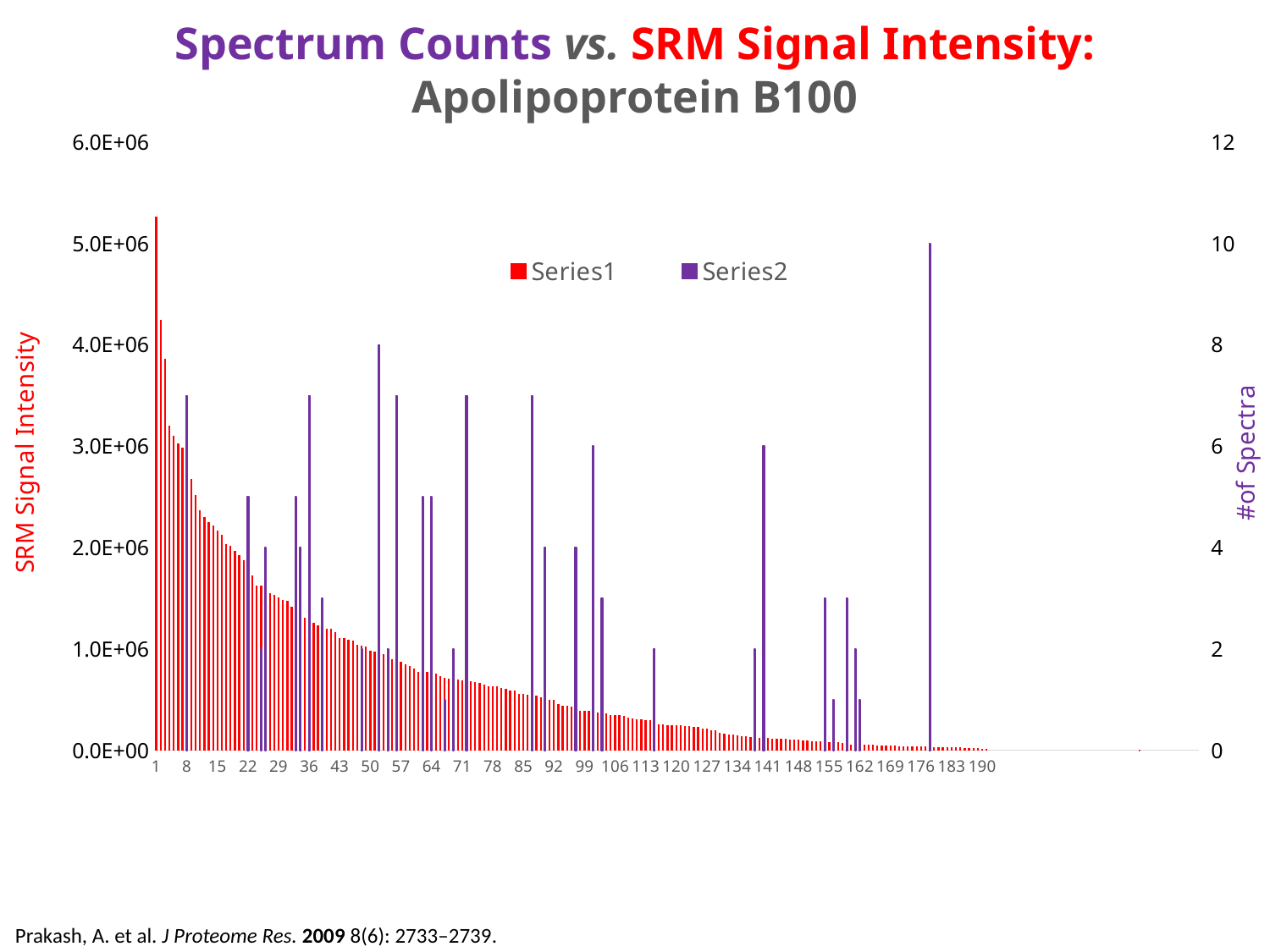
What is the highest value reached by any Series2 (purple) bar on the right axis? 10 Is the Series1 value for category 50 greater or less than 2.0E+06? less What are the two series names shown in the legend? Series1 and Series2 What is the title of the left vertical axis? SRM Signal Intensity Which is larger, the Series1 value for category 1 or the Series1 value for category 8? category 1 Which category has the highest Series1 (red) value? 1 Is the tallest Series2 (purple) bar greater or less than 8 on the right axis? greater What kind of chart is shown on the slide? bar chart How many series does the legend list? 2 Is the Series1 value for category 29 greater or less than 2.0E+06? less Do the Series1 (red) values rise or fall as you move from left to right along the x axis? fall